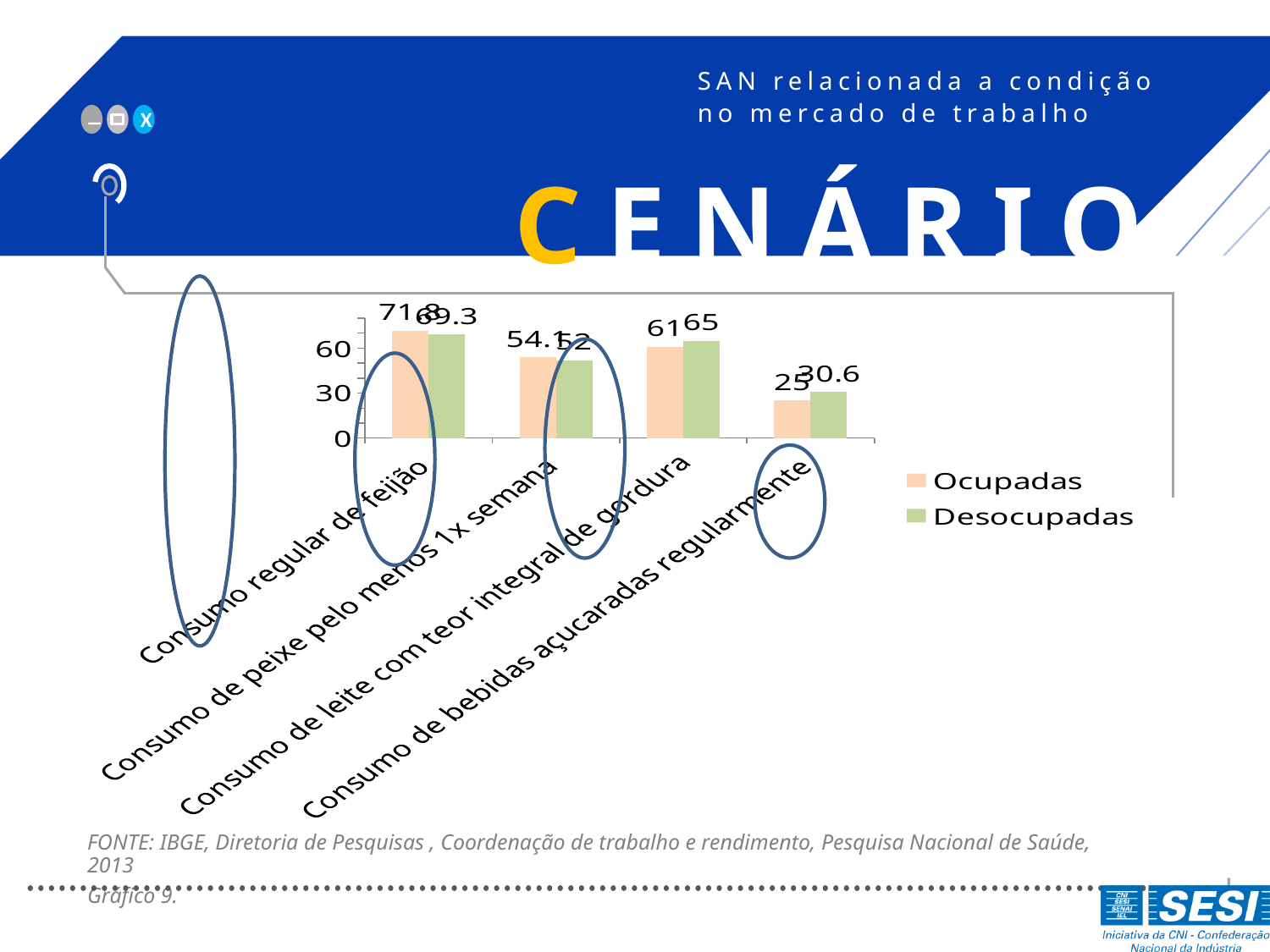
What is the value for Desocupadas in the category 'Consumo de leite com teor integral de gordura'? 65 Is the Ocupadas value for 'Consumo regular de feijão' greater or less than 60? greater What is the value for Desocupadas in the category 'Consumo de bebidas açucaradas regularmente'? 30.6 What is the difference between the Desocupadas and Ocupadas values for 'Consumo de bebidas açucaradas regularmente'? 5.6 Which category has the lowest value for Ocupadas? Consumo de bebidas açucaradas regularmente What kind of chart is shown on the slide? bar chart Which category has the highest value for Desocupadas? Consumo regular de feijão What is the value for Ocupadas in the category 'Consumo de leite com teor integral de gordura'? 61 What is the value for Ocupadas in the category 'Consumo de bebidas açucaradas regularmente'? 25 How many categories are shown on the x axis of the chart? 4 Which series is shown in green in the legend? Desocupadas How many series does the legend list? 2